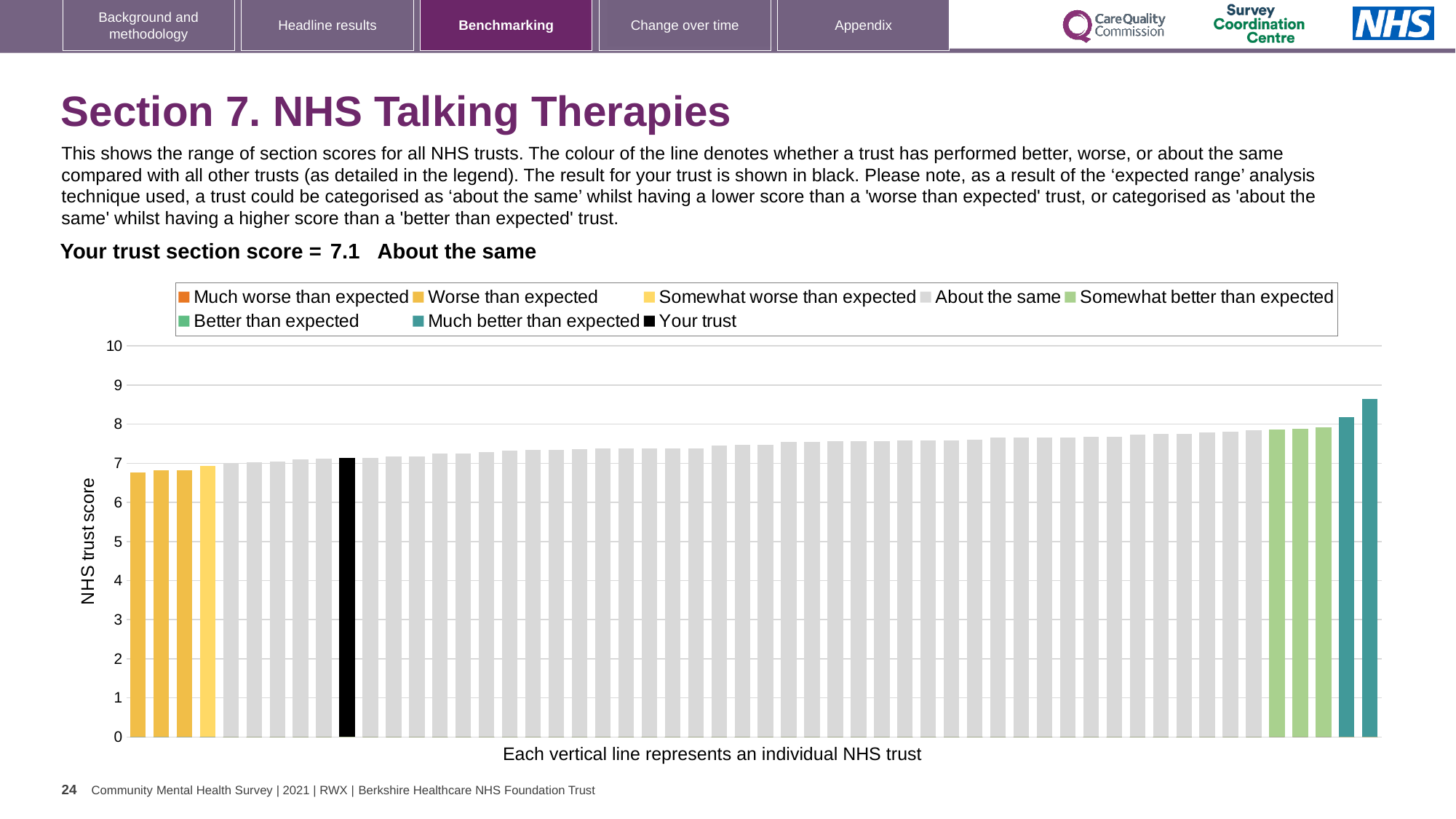
What colour is the bar representing your trust? black How many bars are coloured as 'Somewhat better than expected'? 3 What type of chart is shown on the slide? bar chart Which benchmarking category is your trust placed in for this section? About the same How many entries does the chart legend list? 8 What is the label on the vertical axis of the chart? NHS trust score Do the bar values rise or fall from left to right along the x axis? rise Is the value for your trust greater or less than 5? greater Is the value of the tallest bar greater or less than 8? greater Is the value of the shortest bar greater or less than 7? less What is the section score for your trust shown on the slide? 7.1 How many bars are coloured as 'Much better than expected'? 2